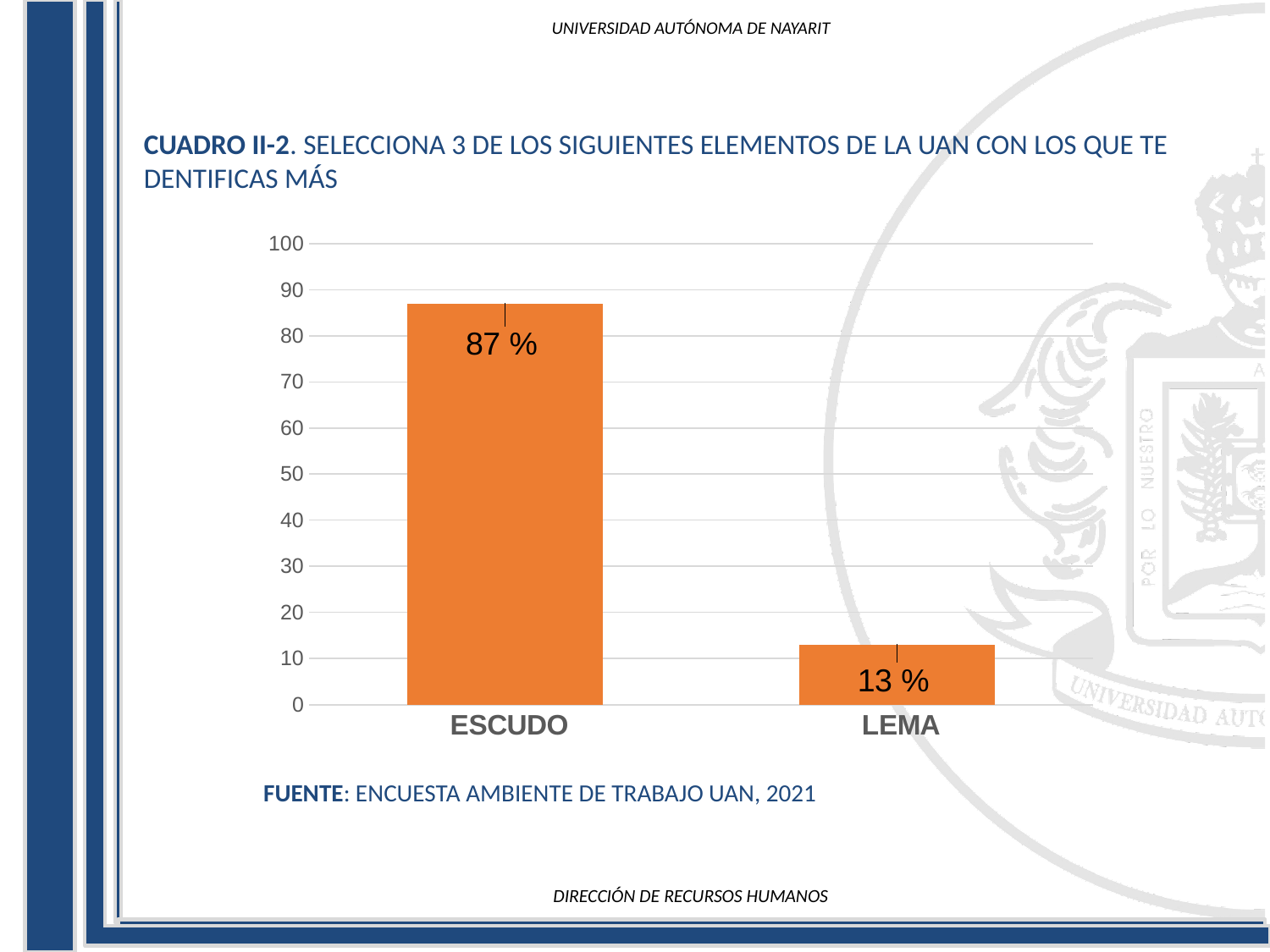
What is the difference between the values for ESCUDO and LEMA? 74 % Which category has the lowest value? LEMA What is the value for LEMA? 13 % What is the highest value shown on the y axis? 100 What is the total of the values for ESCUDO and LEMA? 100 % Is the value for ESCUDO greater or less than 80? greater Is the value for LEMA greater or less than 20? less How many categories are shown on the x axis? 2 What kind of chart is shown on the slide? bar chart What is the value for ESCUDO? 87 % Which is larger, the value for ESCUDO or the value for LEMA? ESCUDO Which category has the highest value? ESCUDO